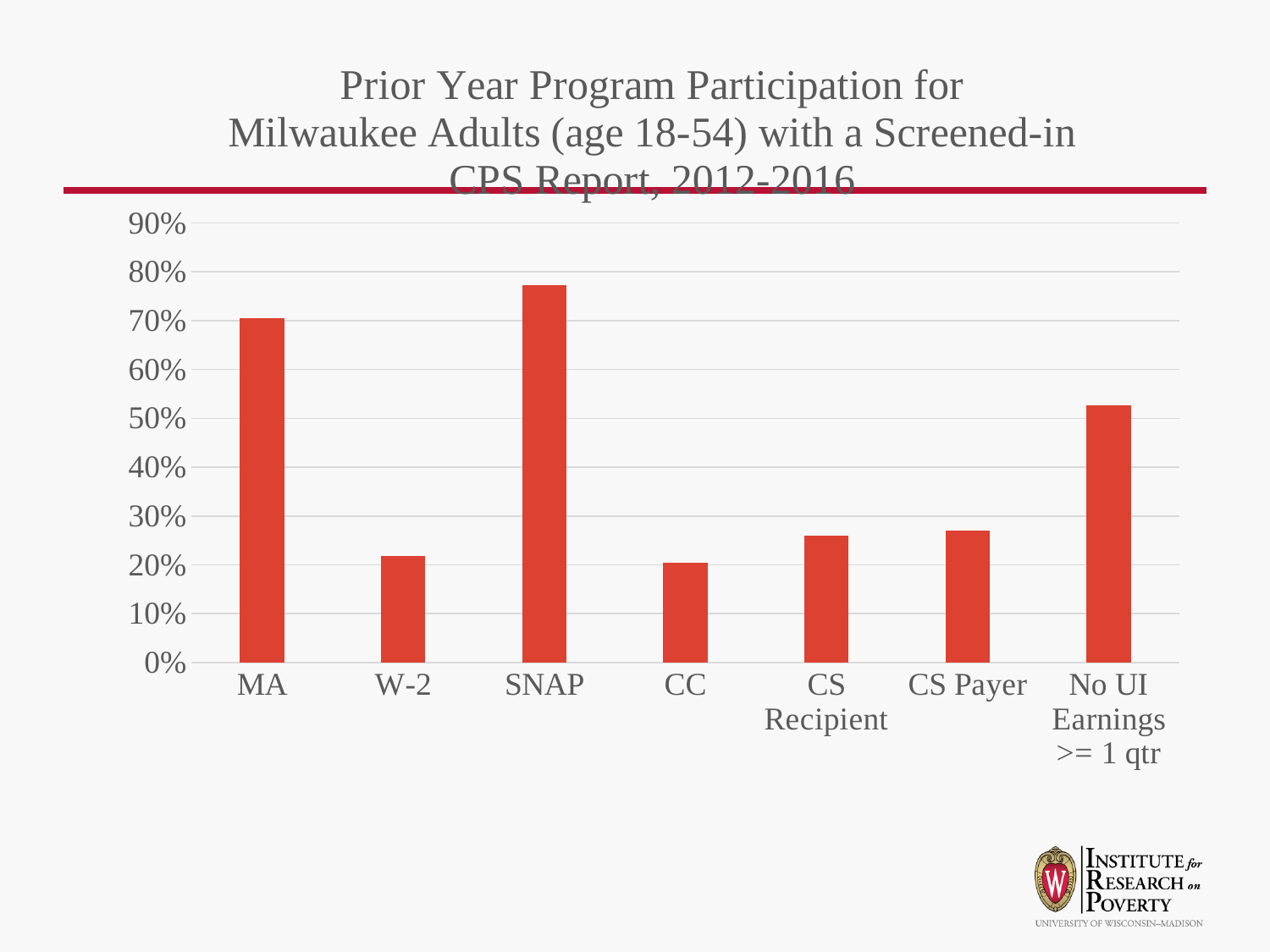
Which is larger, the value for MA or the value for No UI Earnings >= 1 qtr? MA Is the value for CC greater or less than 30%? less Is the value for MA greater or less than 60%? greater Is the value for SNAP greater or less than 70%? greater How many categories are shown on the x axis of the chart? 7 Which category has the highest value in the chart? SNAP Which is larger, the value for SNAP or the value for CS Recipient? SNAP What kind of chart is shown on the slide? bar chart What is the highest value shown on the y axis of the chart? 90%